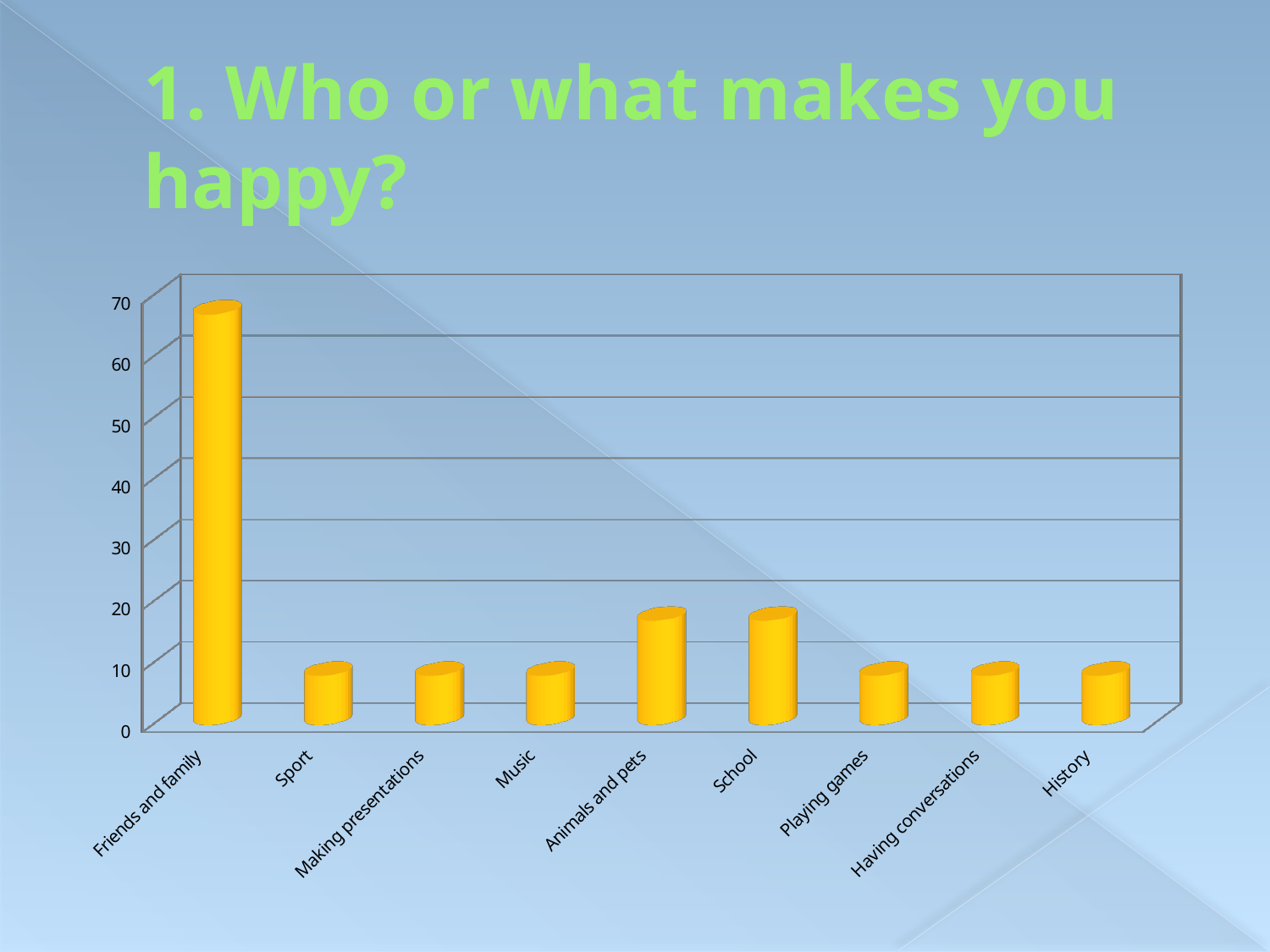
What is the title of the slide containing the chart? 1. Who or what makes you happy? Which category has the highest value in the chart? Friends and family What kind of chart is shown on the slide? bar chart Is the value for Sport greater or less than 20? less Is the value for Friends and family greater or less than 40? greater Is the value for School greater or less than 30? less Which is larger, the value for Animals and pets or the value for Sport? Animals and pets Which is larger, the value for Friends and family or the value for School? Friends and family What colour are the bars in the chart? yellow How many categories are shown on the x axis of the chart? 9